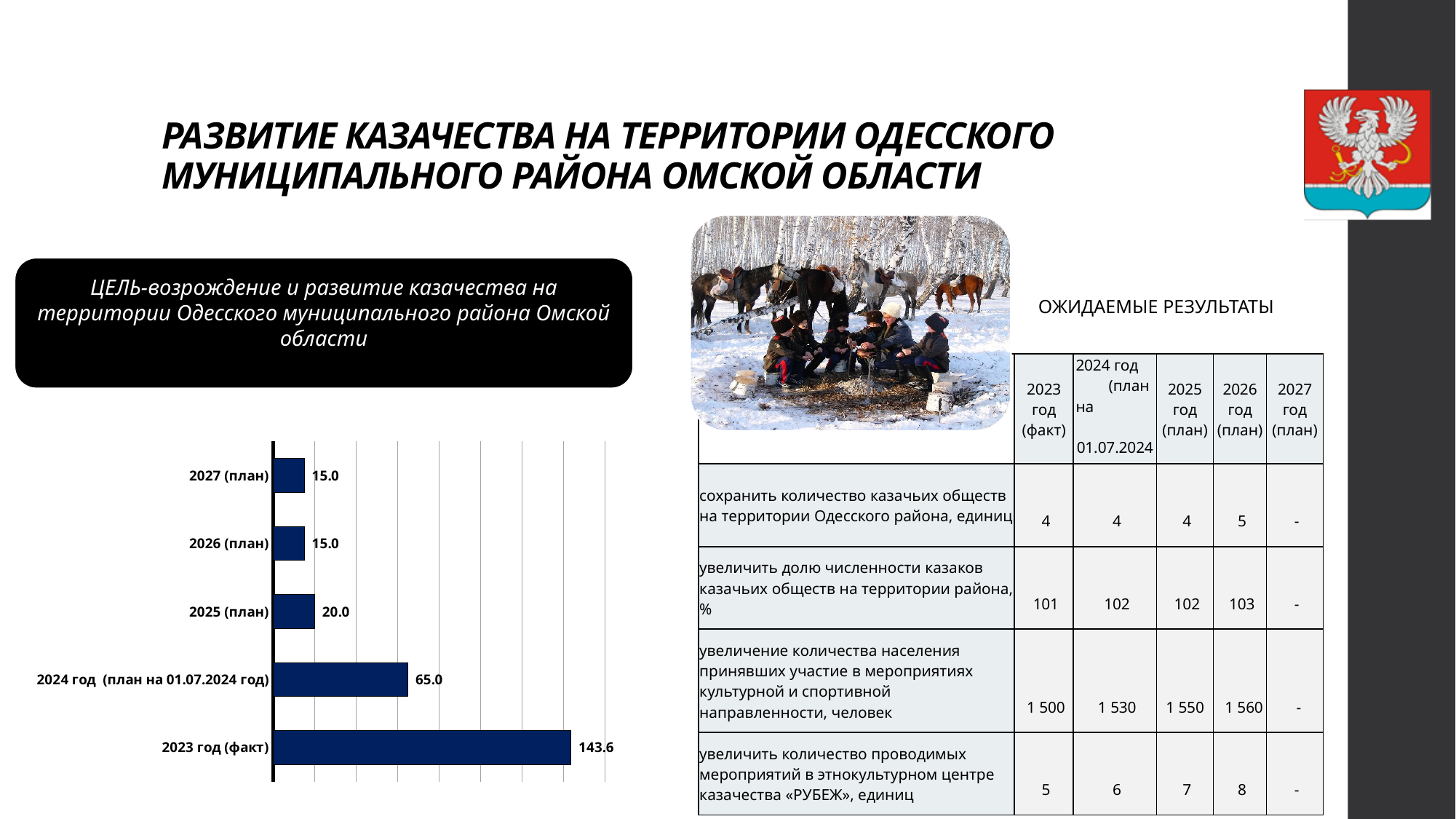
What is the value for 2025 (план) in the bar chart? 20.0 Do the values for 2026 (план) and 2027 (план) differ in the bar chart? No, both are 15.0 How many categories does the bar chart show? 5 What is the difference between the values for 2023 год (факт) and 2024 год (план на 01.07.2024 год)? 78.6 What is the value for 2024 год (план на 01.07.2024 год) in the bar chart? 65.0 What is the value for 2027 (план) in the bar chart? 15.0 Which category has the highest value in the bar chart? 2023 год (факт) What is the difference between the values for 2025 (план) and 2026 (план)? 5.0 What is the value for 2023 год (факт) in the bar chart? 143.6 Which is larger in the bar chart: the value for 2024 год (план на 01.07.2024 год) or the value for 2025 (план)? 2024 год (план на 01.07.2024 год) What type of chart is shown on the slide? bar chart Do the values in the bar chart rise or fall from 2023 год (факт) to 2027 (план)? fall